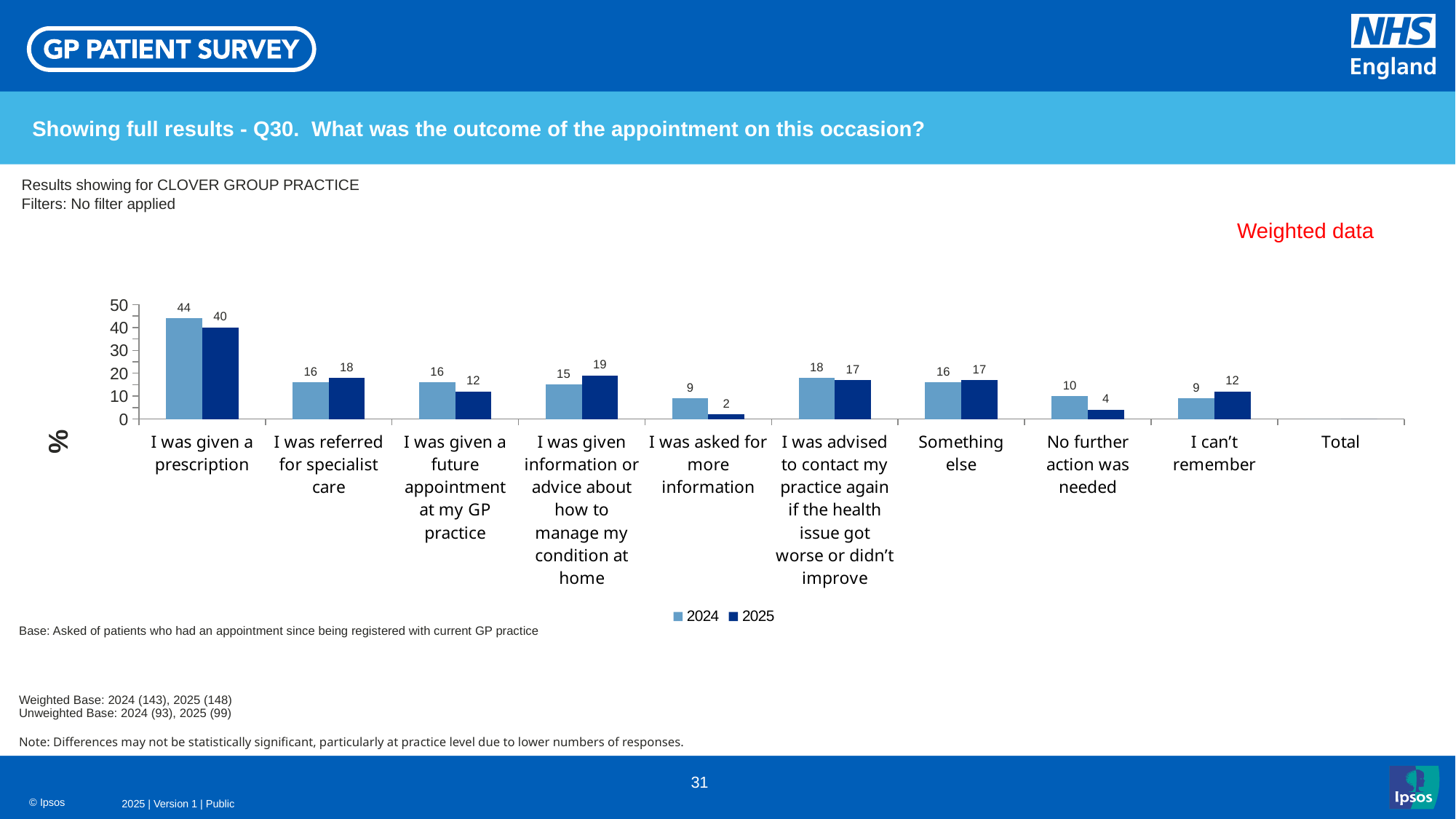
Which category has the lowest 2025 value? I was asked for more information What is the 2025 value for "I was asked for more information"? 2 What kind of chart is shown on the slide? Bar chart For "I was given information or advice about how to manage my condition at home", which year has the larger value, 2024 or 2025? 2025 What is the difference between the 2024 and 2025 values for "No further action was needed"? 6 What is the difference between the 2024 and 2025 values for "I was given a prescription"? 4 Which category has the highest 2025 value? I was given a prescription What is the 2025 value for "No further action was needed"? 4 How many series does the legend list? 2 What is the 2024 value for "I was given a prescription"? 44 Is the 2024 value for "I was given a prescription" greater or less than 40? greater What is the 2024 value for "I was advised to contact my practice again if the health issue got worse or didn't improve"? 18